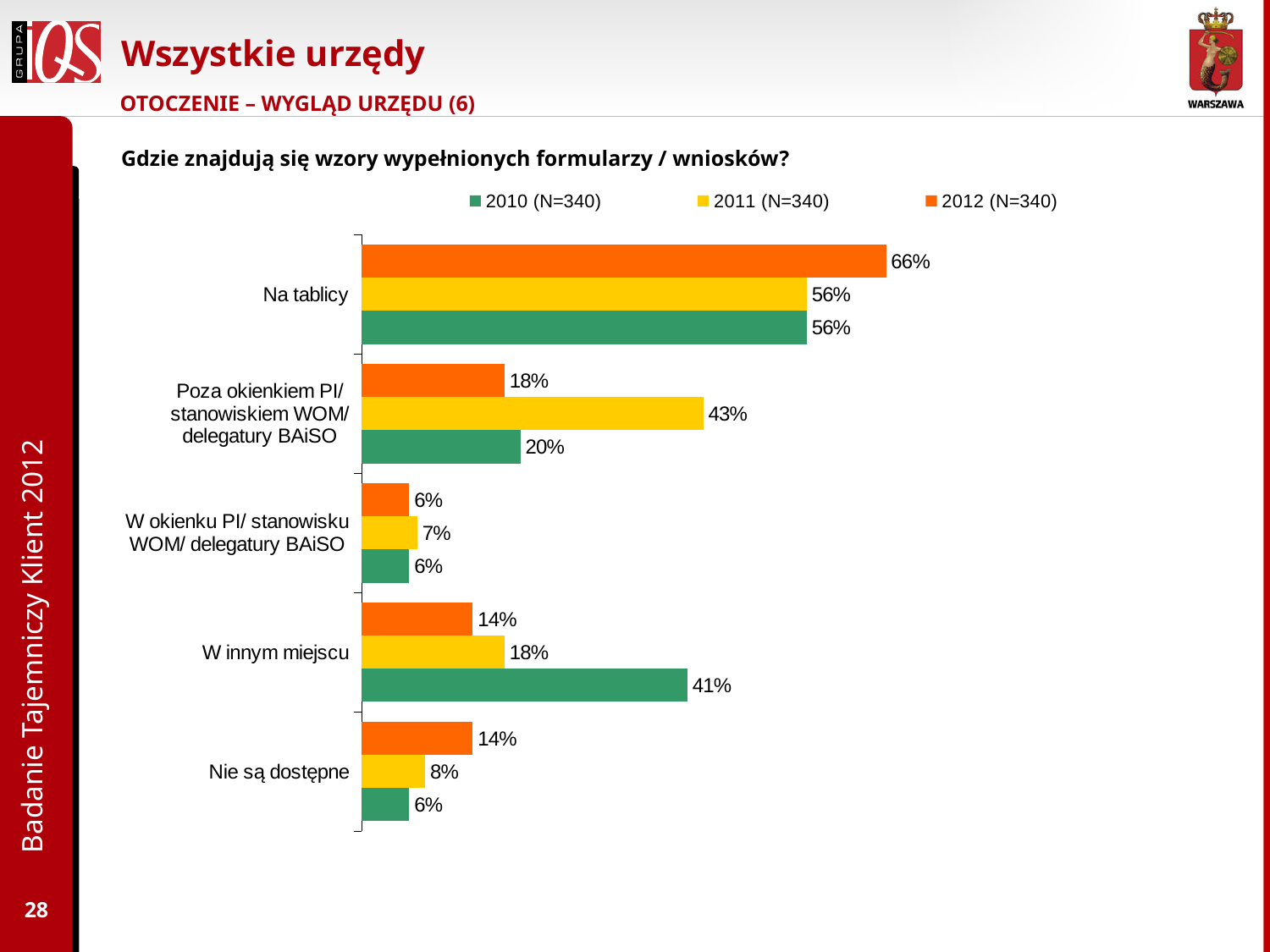
What is the value for "Poza okienkiem PI/ stanowiskiem WOM/ delegatury BAiSO" in the 2011 (N=340) series? 43% What is the value for "Na tablicy" in the 2012 (N=340) series? 66% What kind of chart is shown on the slide? Bar chart How many series does the legend list? 3 What is the difference between the 2010 and 2012 values for "W innym miejscu"? 27 percentage points Which category has the lowest value in the 2011 (N=340) series? W okienku PI/ stanowisku WOM/ delegatury BAiSO Which category has the highest value in the 2012 (N=340) series? Na tablicy For "Poza okienkiem PI/ stanowiskiem WOM/ delegatury BAiSO", which series has the larger value: 2011 or 2012? 2011 What is the value for "Nie są dostępne" in the 2012 (N=340) series? 14% What is the value for "W innym miejscu" in the 2010 (N=340) series? 41% What is the difference between the 2012 and 2011 values for "Na tablicy"? 10 percentage points How many categories are shown on the chart? 5